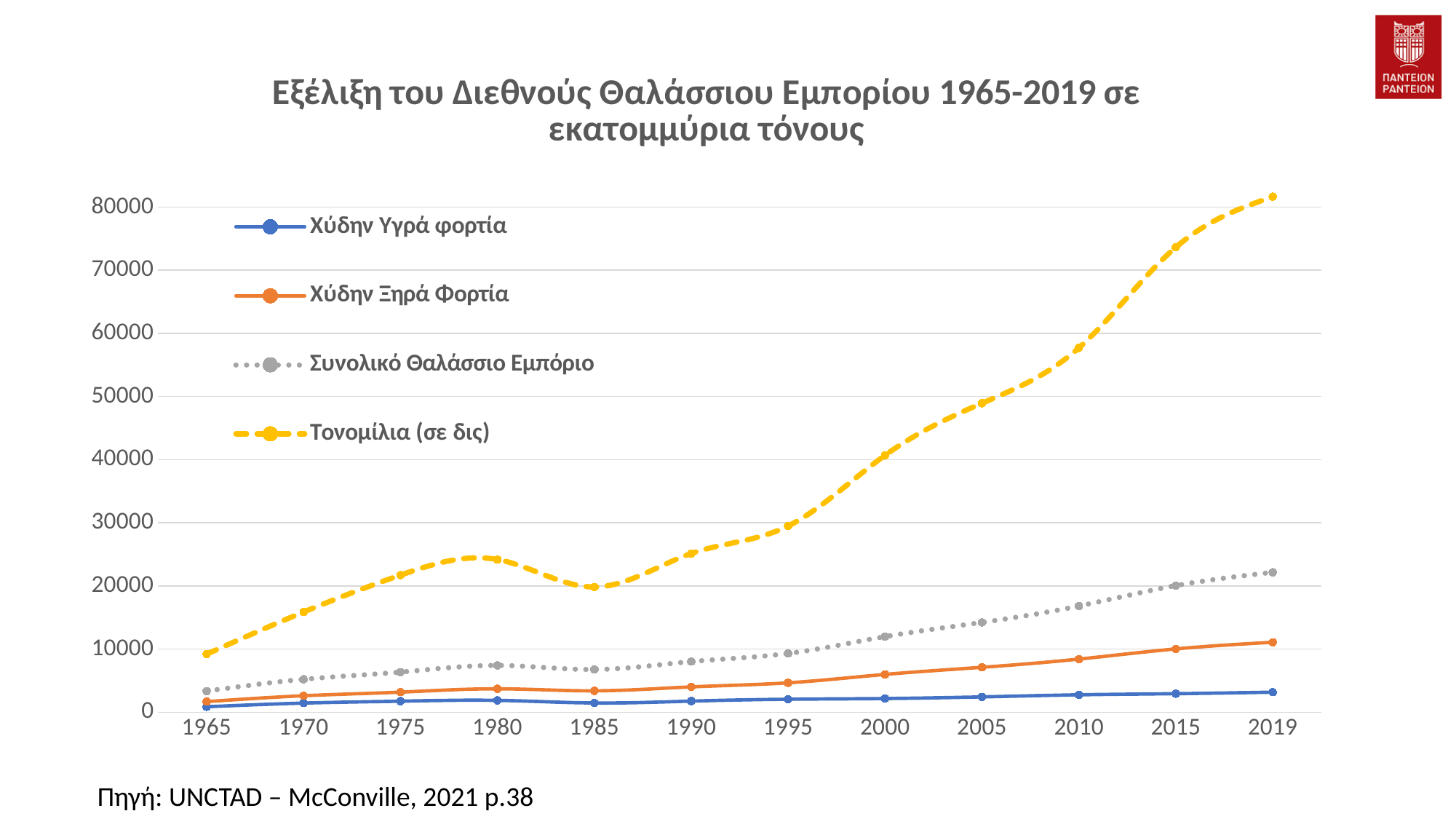
Does the Τονομίλια (σε δις) series rise or fall between 1980 and 1985? falls What kind of chart is shown on the slide? line chart Which series has the lowest value in 2019? Χύδην Υγρά φορτία Is the value for Συνολικό Θαλάσσιο Εμπόριο in 2019 greater or less than 20000? greater Is the value for Τονομίλια (σε δις) in 2019 greater or less than 70000? greater How many series does the legend list? 4 Does the Συνολικό Θαλάσσιο Εμπόριο series rise or fall from 1965 to 2019? rises Which series is drawn with a yellow dashed line? Τονομίλια (σε δις) Which is larger for Τονομίλια (σε δις): the value in 1980 or the value in 1985? 1980 How many years are marked along the x axis? 12 Which series has the highest value in 2019? Τονομίλια (σε δις) Is the value for Τονομίλια (σε δις) in 1965 greater or less than 20000? less